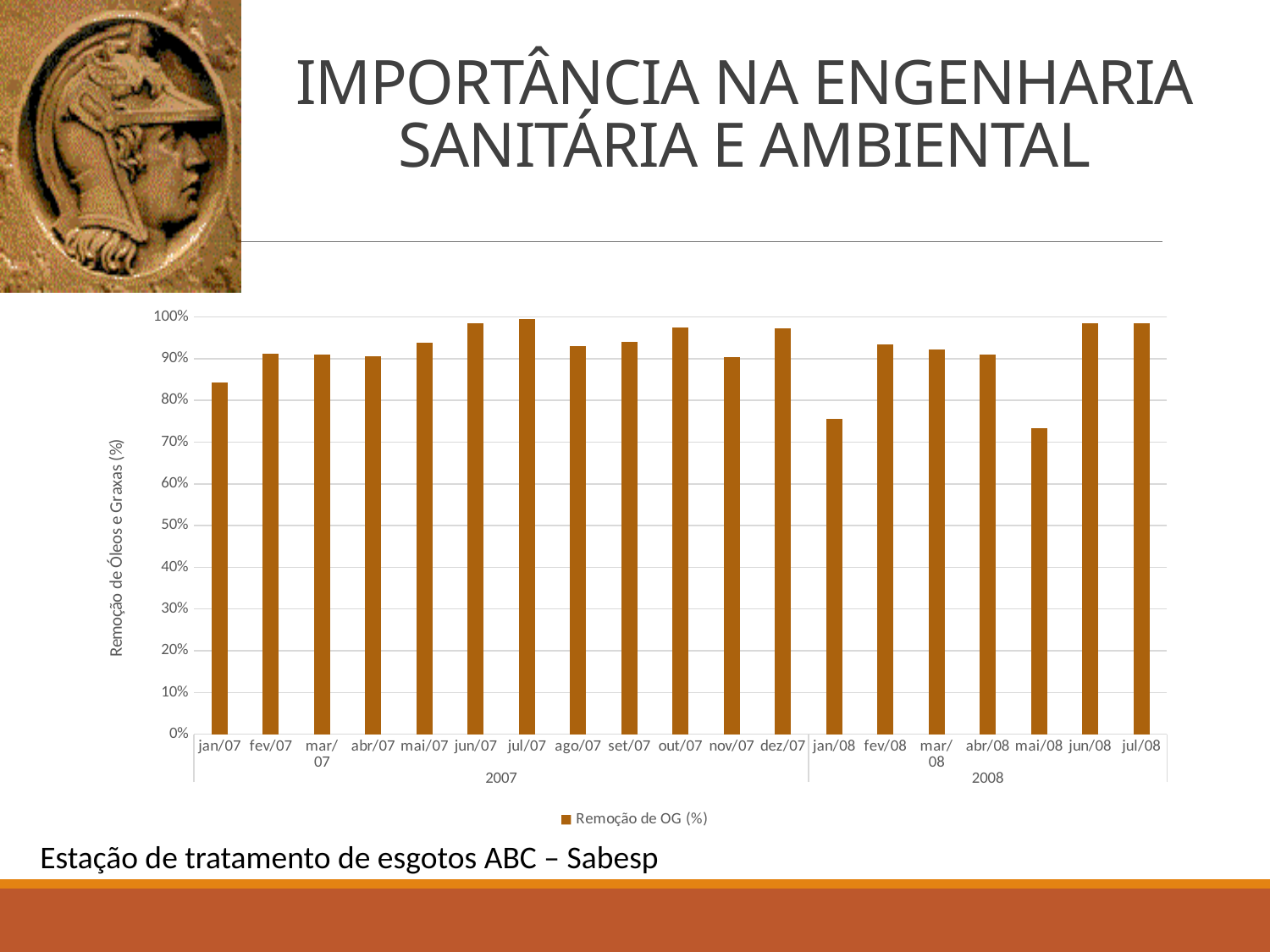
What is the title of the vertical axis of the chart? Remoção de Óleos e Graxas (%) Which is larger, the value for mai/08 or the value for jun/08? jun/08 How many series does the chart legend list? 1 Which month has the lowest value in the chart? mai/08 Is the value for jul/07 greater or less than 90%? greater What kind of chart is shown on the slide? bar chart Which is larger, the value for jan/07 or the value for fev/07? fev/07 Is the value for jan/07 greater or less than 90%? less What is the legend entry for the series in the chart? Remoção de OG (%) How many months (bars) are plotted in the chart? 19 Is the value for jan/08 greater or less than 80%? less